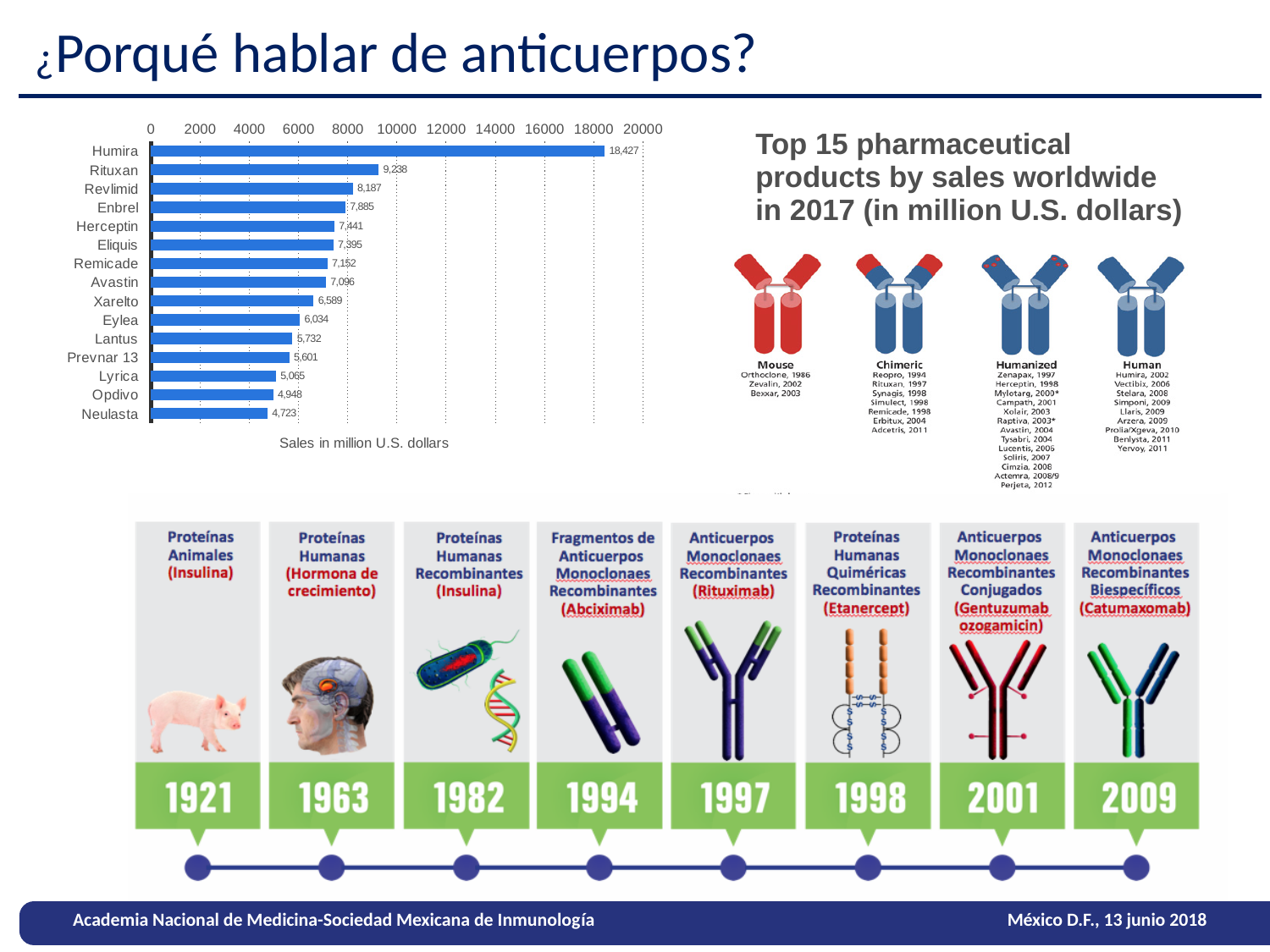
What is the difference in sales between Humira and Rituxan, in million U.S. dollars? 9,189 What kind of chart is used to show the pharmaceutical product sales? Bar chart Which product has the highest sales in the chart? Humira What are the sales in million U.S. dollars for Xarelto? 6,589 What are the sales in million U.S. dollars for Neulasta? 4,723 Which product has the lowest sales in the chart? Neulasta How many pharmaceutical products are shown in the bar chart? 15 Is the value for Lantus greater or less than 6000? less Which has higher sales, Enbrel or Eylea? Enbrel What is the label on the horizontal axis of the bar chart? Sales in million U.S. dollars What are the sales in million U.S. dollars for Rituxan? 9,238 What are the sales in million U.S. dollars for Humira? 18,427